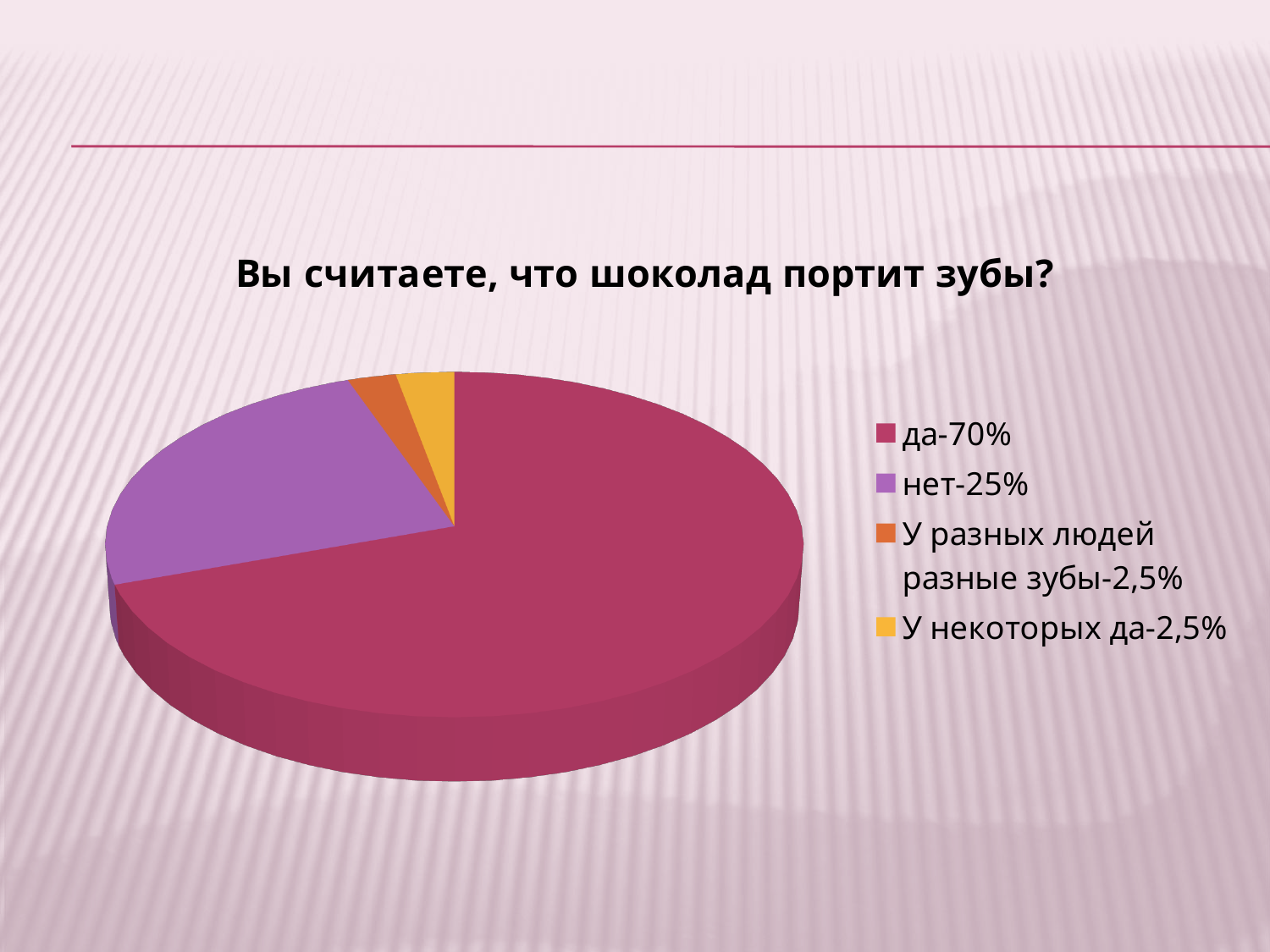
What kind of chart is shown on the slide? pie chart What is the title of the chart? Вы считаете, что шоколад портит зубы? What colour is the slice for "нет"? purple What is the combined share of "да" and "нет"? 95% What is the difference between the shares for "да" and "нет"? 45% Which answer has the largest share of the pie? да What share of the pie is labelled "У некоторых да"? 2,5% What share of the pie is labelled "да"? 70% What share of the pie is labelled "У разных людей разные зубы"? 2,5% How many slices does the pie chart have? 4 Which is larger, the share for "нет" or the share for "У некоторых да"? нет